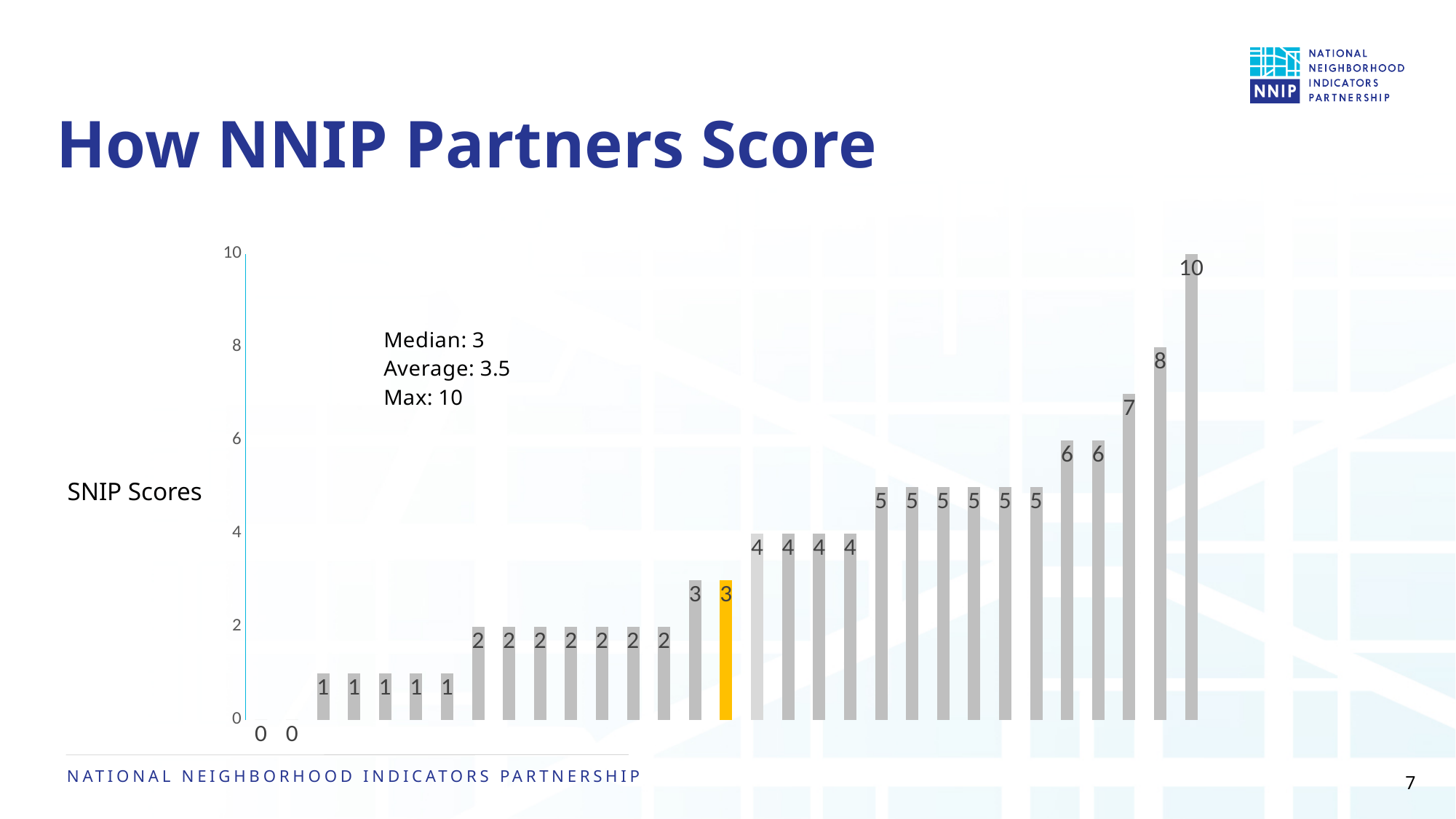
What kind of chart is shown on the slide? bar chart Is the value of the tallest bar greater or less than 8? greater What is the highest value shown by any bar in the chart? 10 Do the bar values rise or fall from left to right across the chart? rise What is the value of the bar highlighted in yellow? 3 What average value is stated in the text on the chart? 3.5 What is the difference between the highest bar value and the second-highest bar value? 2 What median value is stated in the text on the chart? 3 What is the lowest value shown by any bar in the chart? 0 How many bars have a value of 5? 6 How many bars are plotted in the chart? 31 How many bars have a value of 2? 7